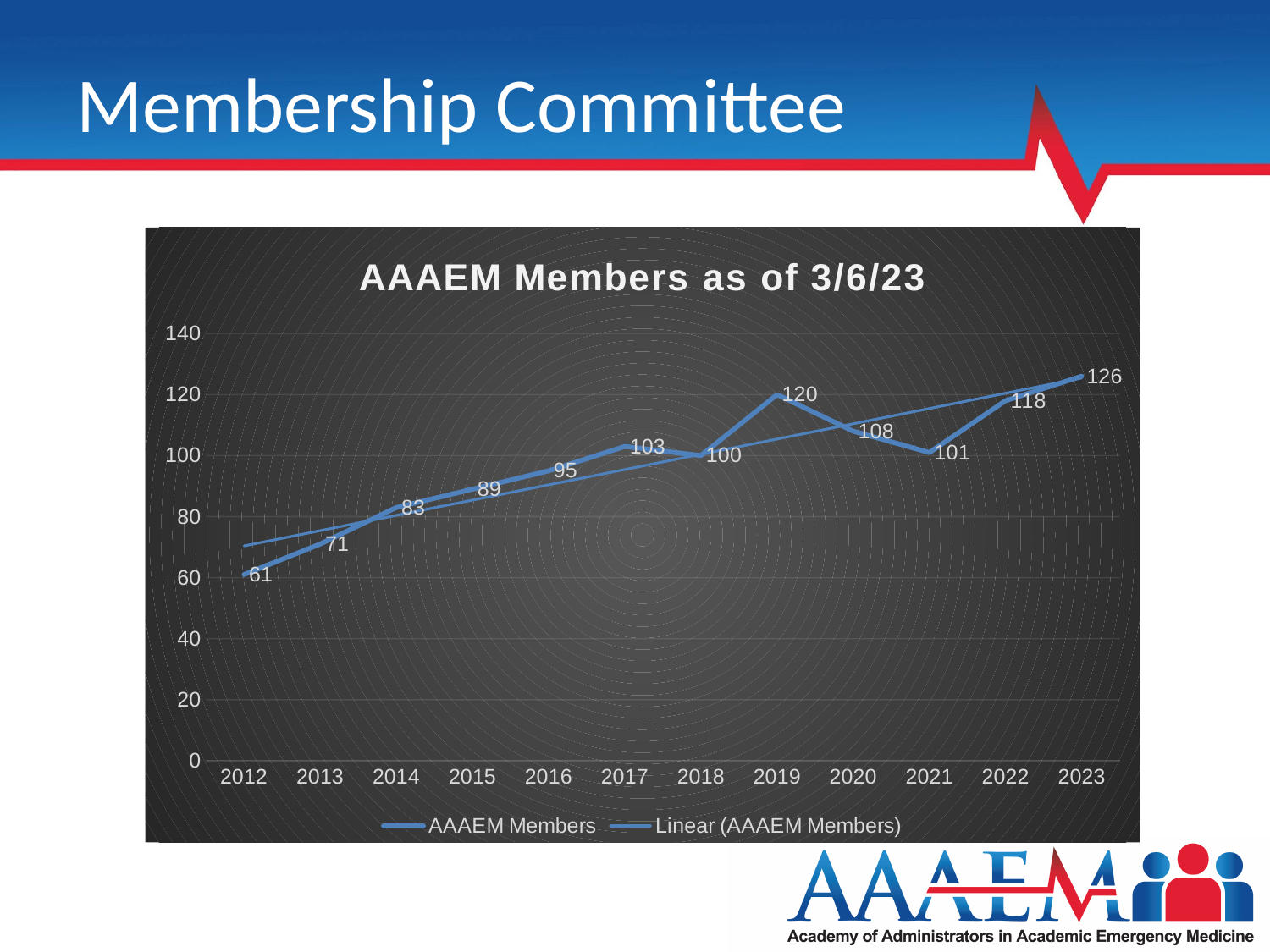
How many years are shown on the x axis of the chart? 12 What is the difference between the AAAEM Members values for 2019 and 2020? 12 What kind of chart is shown on the slide? line chart What is the difference between the AAAEM Members values for 2023 and 2012? 65 Which year has the lowest number of AAAEM Members? 2012 What is the value for 2021 in the AAAEM Members chart? 101 Is the AAAEM Members value for 2016 greater or less than 100? less Which year has a larger AAAEM Members value, 2017 or 2021? 2017 What is the title of the chart? AAAEM Members as of 3/6/23 What is the value for 2012 in the AAAEM Members chart? 61 What is the value for 2019 in the AAAEM Members chart? 120 Which year has the highest number of AAAEM Members? 2023